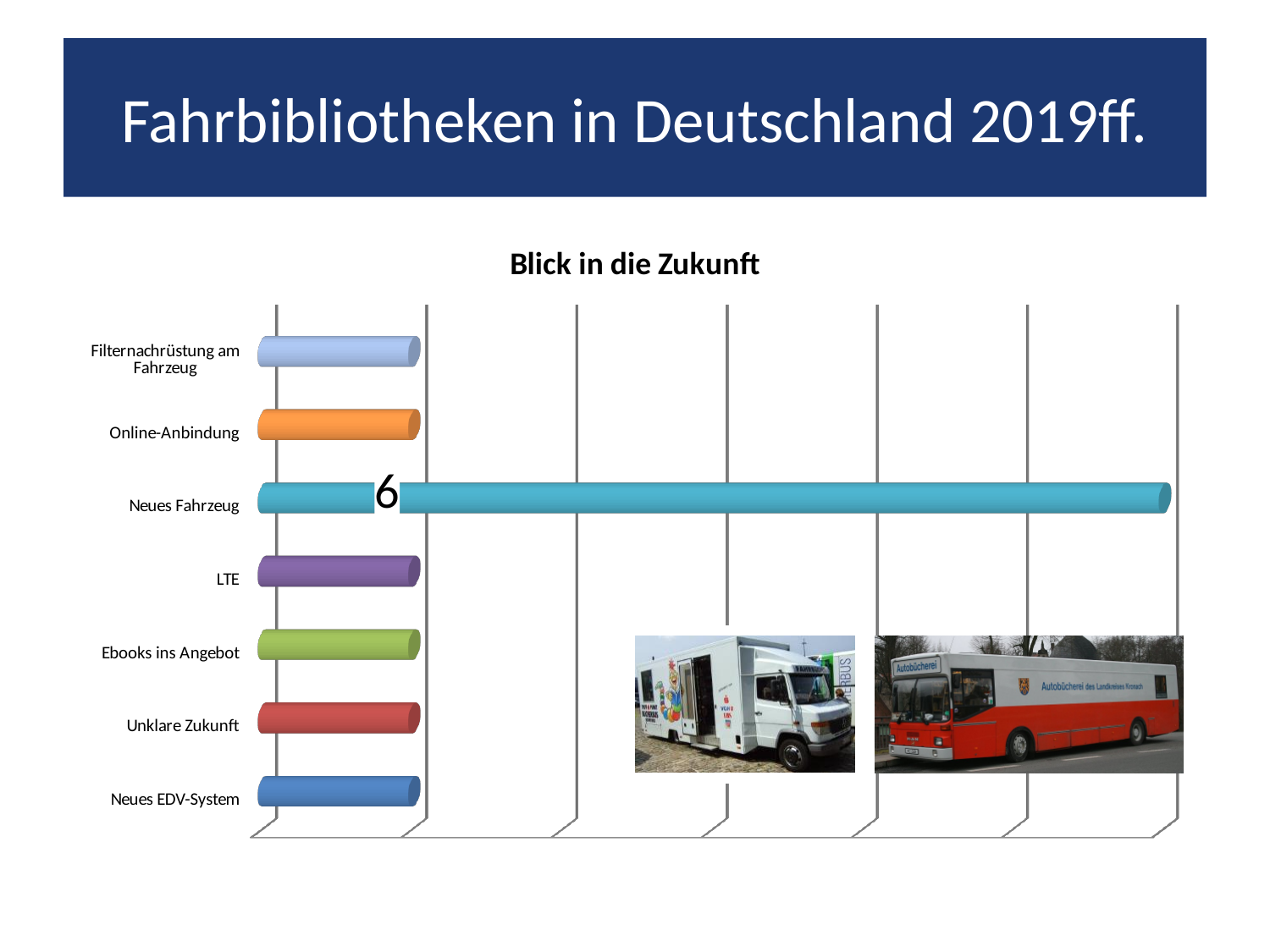
How many categories does the chart show? 7 Which is larger, the value for Neues Fahrzeug or the value for LTE? Neues Fahrzeug What is the title of the chart? Blick in die Zukunft Which is larger, the value for Online-Anbindung or the value for Neues Fahrzeug? Neues Fahrzeug Which category has the highest value? Neues Fahrzeug Which category is listed at the bottom of the chart? Neues EDV-System What kind of chart is shown on the slide? bar chart Which category is listed at the top of the chart? Filternachrüstung am Fahrzeug What is the value for Neues Fahrzeug? 6 Which is larger, the value for Neues EDV-System or the value for Neues Fahrzeug? Neues Fahrzeug